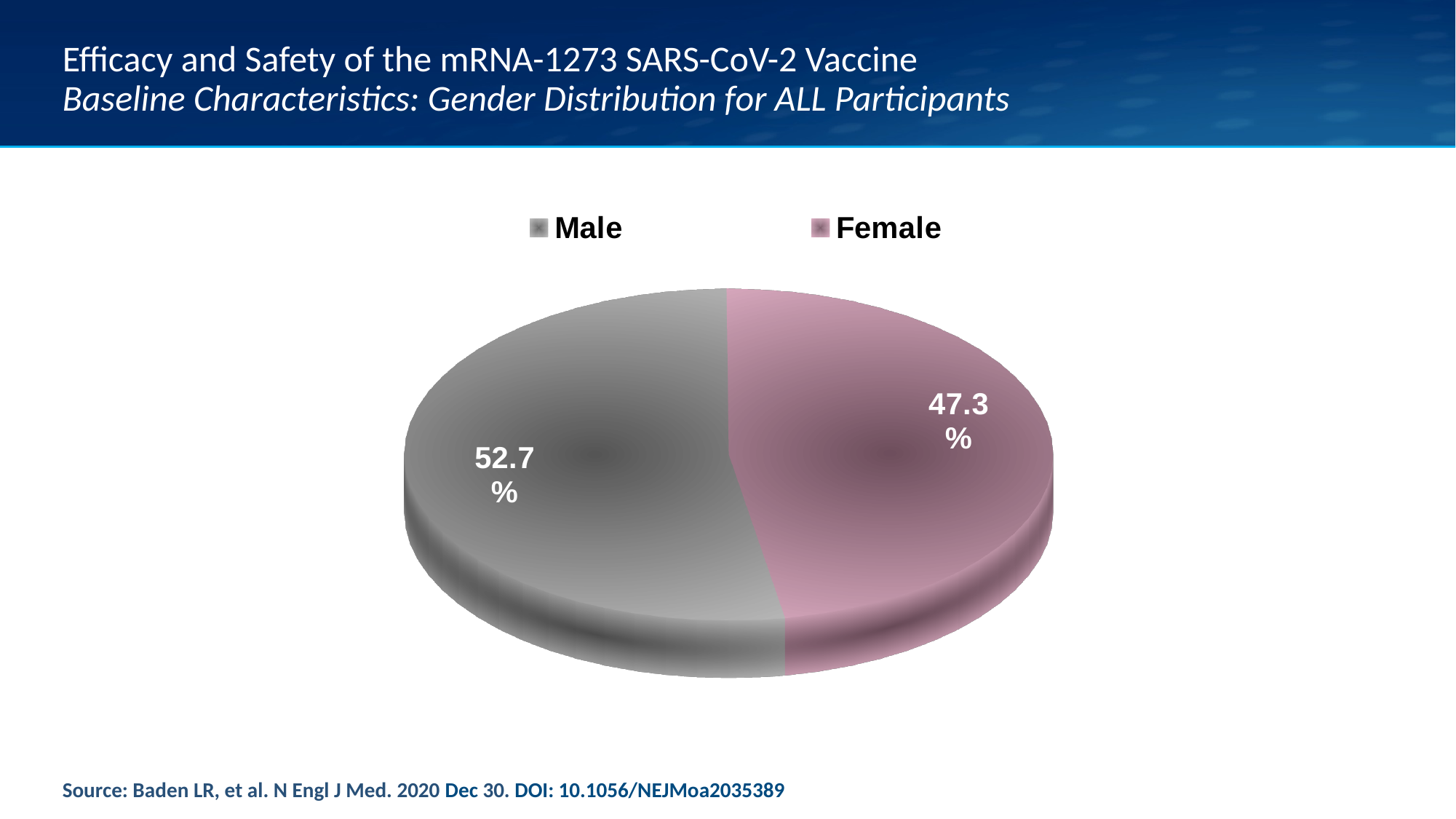
What is the total of the two slices shown? 100% How many slices does the pie chart have? 2 What percentage of participants are Male? 52.7% Which gender has the smaller share of participants? Female What percentage of participants are Female? 47.3% What is the difference in percentage points between the Male and Female shares? 5.4 Which colour represents Male in the pie chart? grey Which gender has the larger share of participants? Male How many entries does the legend list? 2 What kind of chart is shown on the slide? pie chart Is the Male share larger or smaller than the Female share? larger Which colour represents Female in the pie chart? pink